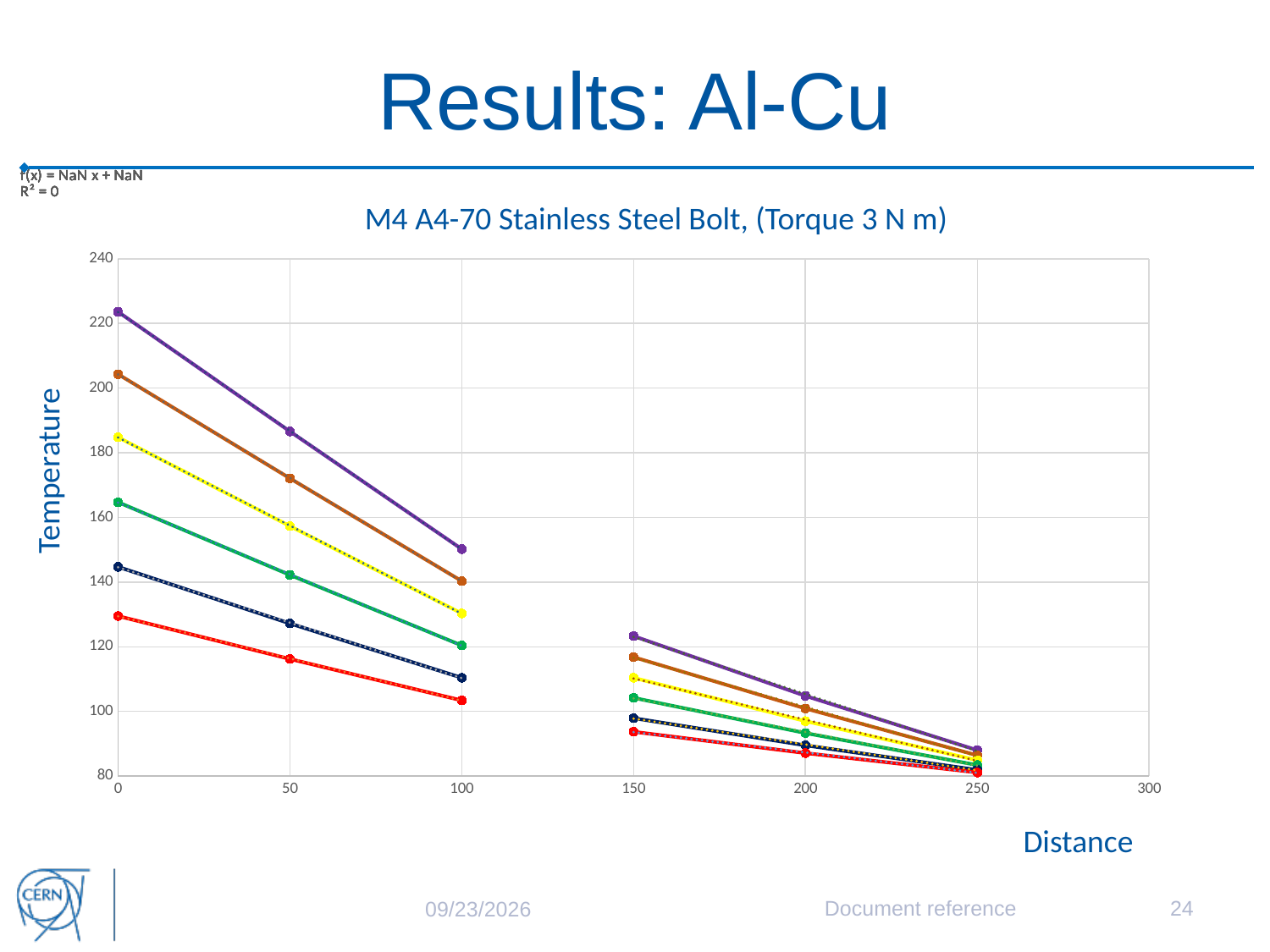
What is the label of the vertical axis of the chart? Temperature At distance 100, is the temperature of the purple line larger or smaller than that of the red line? larger Is the temperature of the red line at distance 0 greater or less than 140? less What kind of chart is shown on the slide? line chart At how many distance values does each line have a plotted point? 6 Is the temperature of the purple line at distance 50 greater or less than 180? greater How many distinct coloured lines are plotted on the chart? 6 What is the title of the chart? M4 A4-70 Stainless Steel Bolt, (Torque 3 N m) Which coloured line has the highest temperature at distance 0? purple Which coloured line has the lowest temperature at distance 0? red Do the temperature values rise or fall as distance increases along the x axis? fall Is the temperature of the yellow line at distance 100 greater or less than 140? less